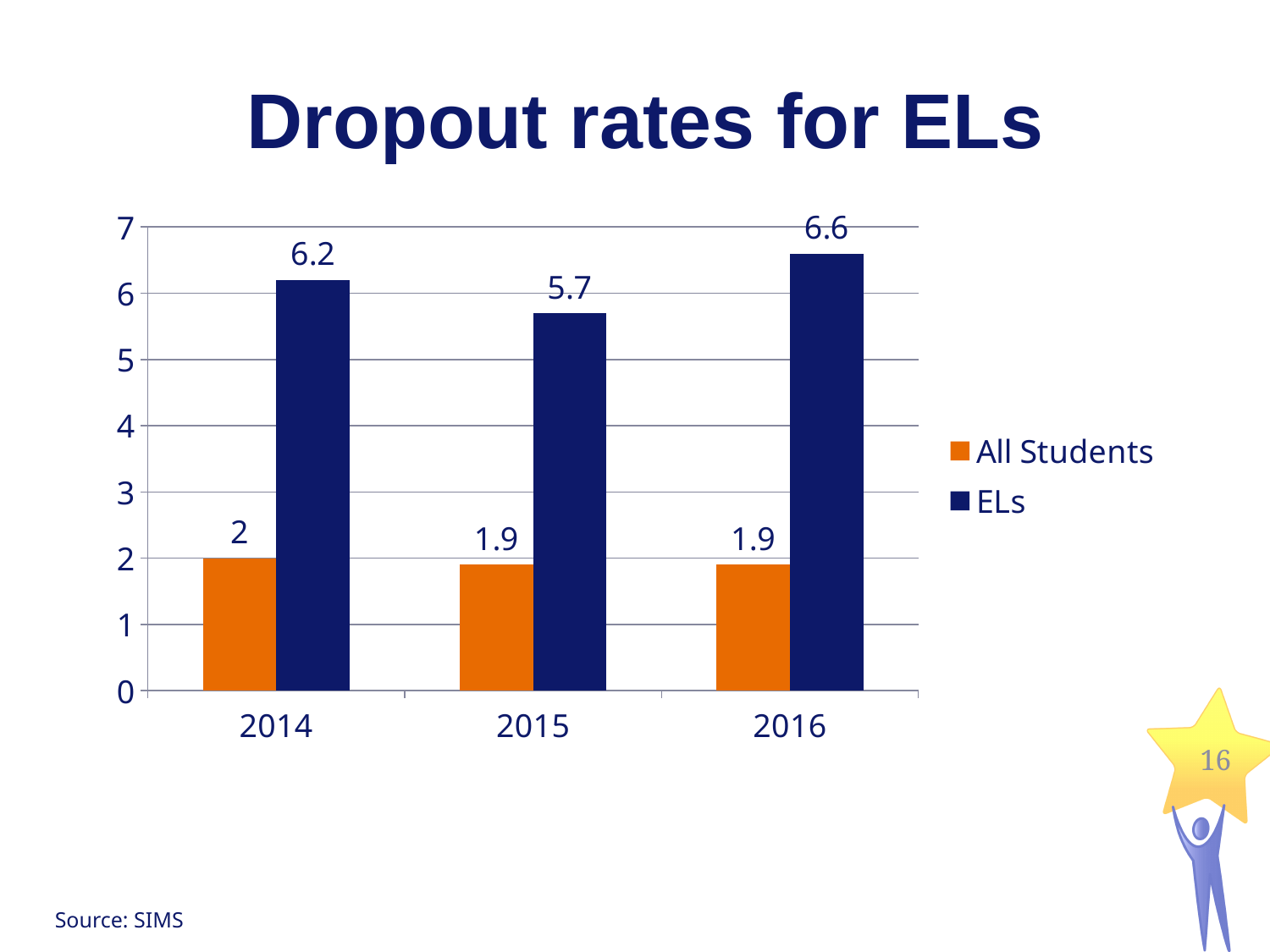
What kind of chart is shown on the slide? bar chart Which is larger in 2014, the dropout rate for ELs or for All Students? ELs Is the ELs dropout rate in 2015 greater or less than 5? greater What is the difference between the ELs dropout rates in 2016 and 2015? 0.9 In which year is the ELs dropout rate highest? 2016 What is the dropout rate for ELs in 2016? 6.6 What is the dropout rate for All Students in 2015? 1.9 In which year is the ELs dropout rate lowest? 2015 What is the difference between the ELs and All Students dropout rates in 2016? 4.7 How many years are shown on the x axis? 3 What is the dropout rate for ELs in 2014? 6.2 How many series does the legend list? 2